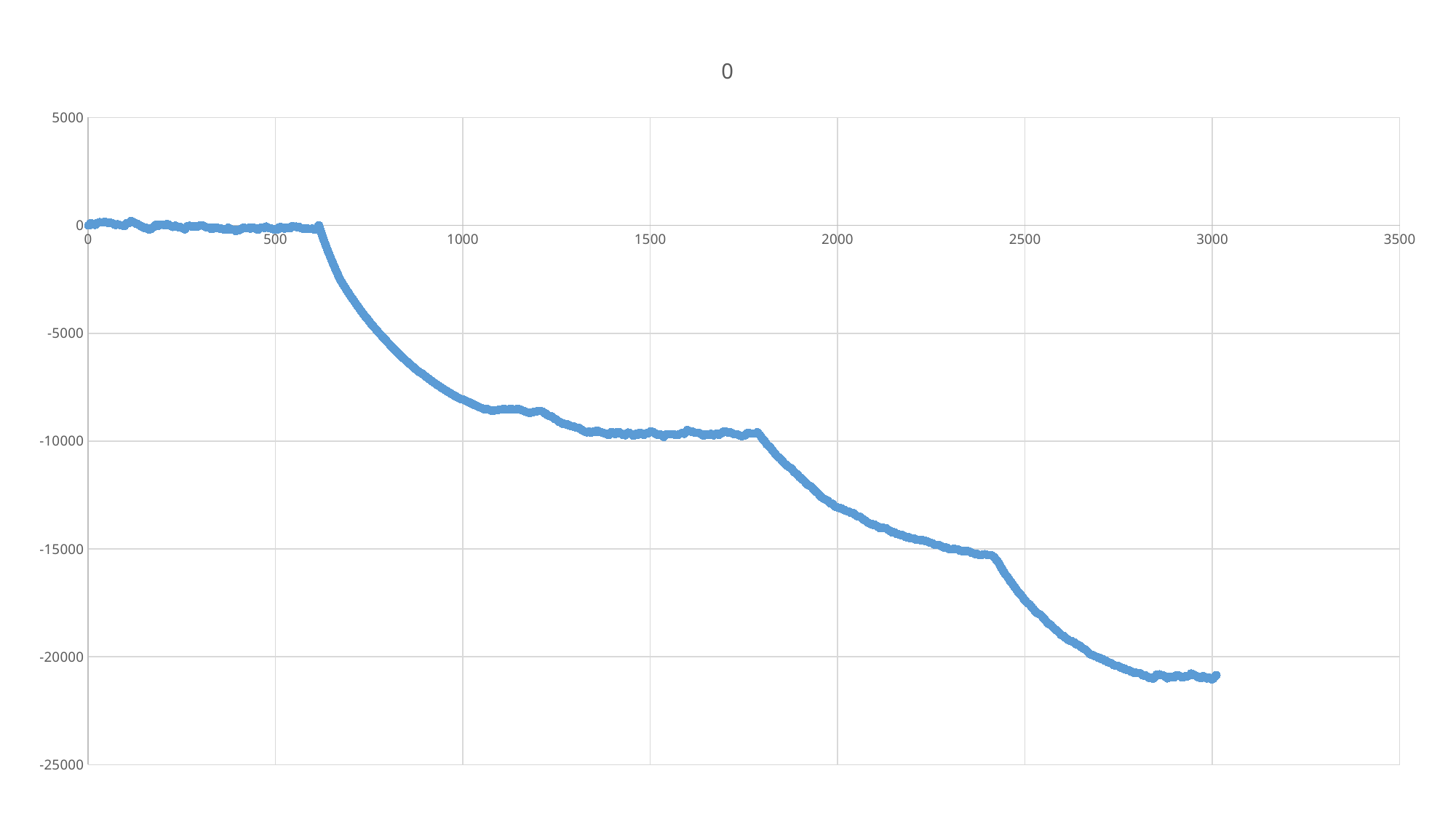
Is the plotted value at x = 2000 greater or less than -10000? less Is the plotted value at x = 3000 greater or less than -20000? less Do the plotted values generally rise or fall as x increases from 0 to 3000? fall What kind of chart is shown on the slide? scatter chart Is the plotted value at x = 2500 greater or less than -15000? less What is the title of the chart? 0 Which is larger, the plotted value at x = 1000 or the plotted value at x = 3000? x = 1000 What is the lowest value shown on the vertical axis? -25000 Which is larger, the plotted value at x = 500 or the plotted value at x = 2500? x = 500